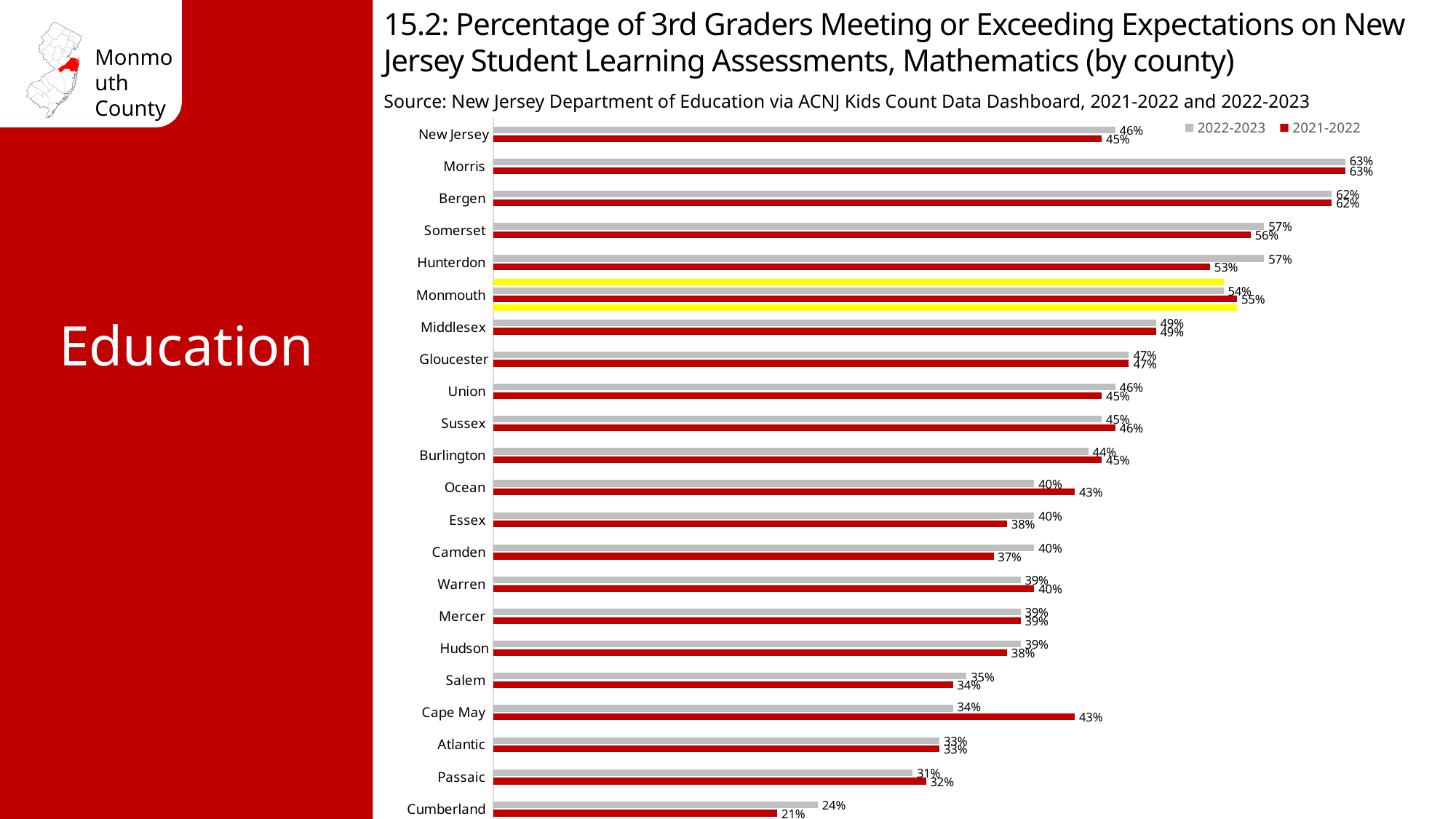
How many series does the legend list? 2 What is the difference between the 2021-2022 and 2022-2023 values for Cape May? 9% What is the difference between the 2022-2023 and 2021-2022 values for Hunterdon? 4% What kind of chart is shown on the slide? Bar chart Which is larger for Ocean, the 2022-2023 value or the 2021-2022 value? 2021-2022 How many categories (counties plus New Jersey) are shown on the chart? 22 Which county has the highest 2022-2023 value? Morris What is the 2022-2023 value for Hunterdon? 57% What is the 2022-2023 value for Monmouth? 54% What is the 2021-2022 value for Cape May? 43% Which is larger for Cumberland, the 2022-2023 value or the 2021-2022 value? 2022-2023 Which county has the lowest 2021-2022 value? Cumberland